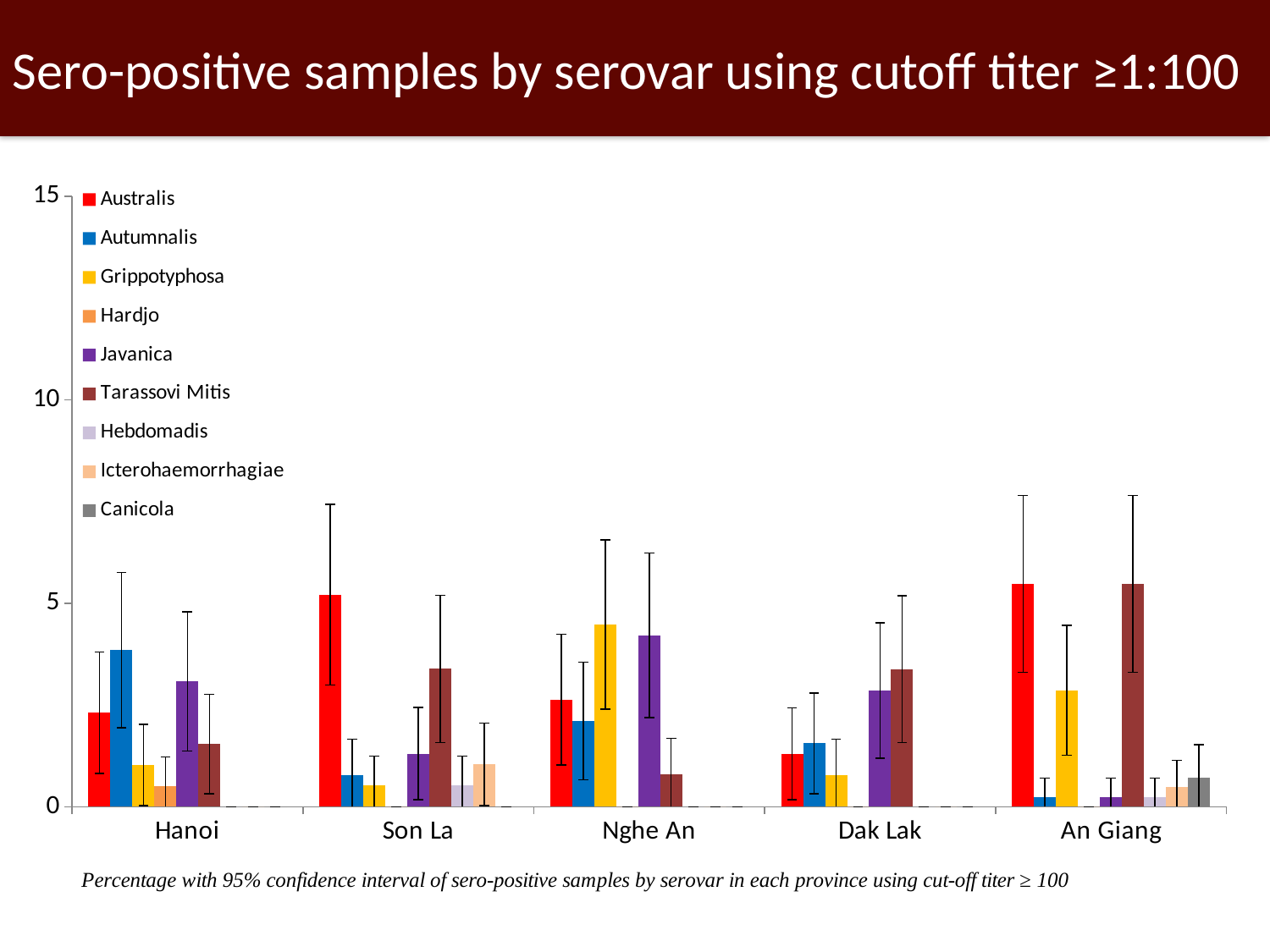
How many provinces are shown on the x axis of the chart? 5 What kind of chart is shown on the slide? bar chart In Dak Lak, which is larger: Australis or Tarassovi Mitis? Tarassovi Mitis What colour represents Australis in the chart? red Is the value for Grippotyphosa in Nghe An greater or less than 5? less Is the value for Australis in An Giang greater or less than 5? greater Is the value for Autumnalis in Hanoi greater or less than 5? less How many serovars does the legend list? 9 In Hanoi, which is larger: Australis or Autumnalis? Autumnalis In Son La, which is larger: Australis or Tarassovi Mitis? Australis Which serovar has the highest value in Son La? Australis